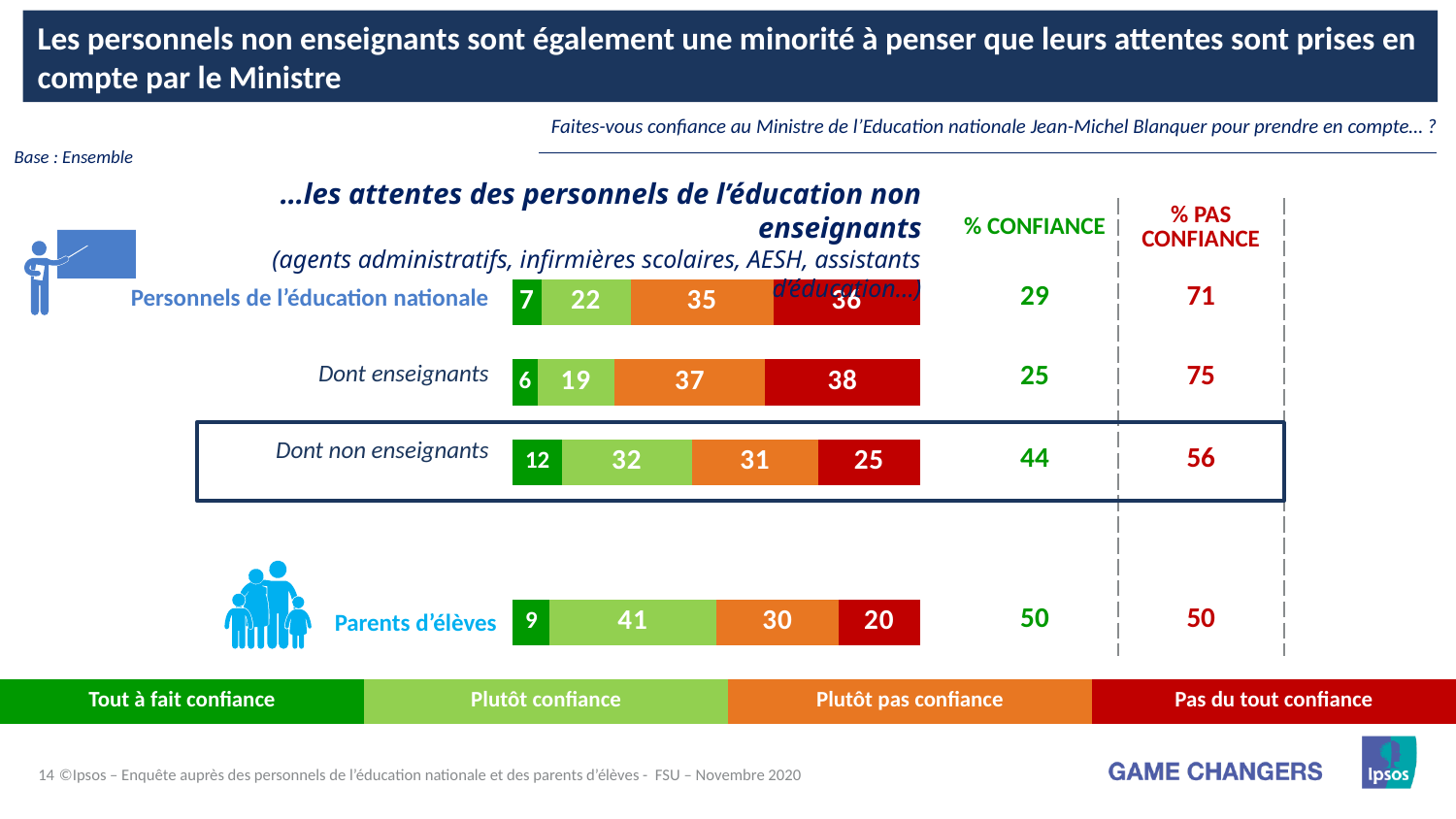
What kind of chart is shown on the slide? Stacked bar chart Which category has the highest 'Pas du tout confiance' value? Dont enseignants Which is larger: the 'Plutôt confiance' value for 'Dont non enseignants' or for 'Dont enseignants'? Dont non enseignants How many categories (rows) are plotted in the chart? 4 What is the 'Plutôt confiance' value for 'Parents d'élèves'? 41 What is the difference between the '% PAS CONFIANCE' values for 'Dont enseignants' and 'Dont non enseignants'? 19 What is the '% CONFIANCE' value for 'Personnels de l'éducation nationale'? 29 Which category has the lowest '% CONFIANCE' value? Dont enseignants What is the 'Pas du tout confiance' value for 'Dont enseignants'? 38 What is the 'Tout à fait confiance' value for 'Dont non enseignants'? 12 How many series does the legend at the bottom list? 4 What is the total of the stacked bar for 'Parents d'élèves'? 100